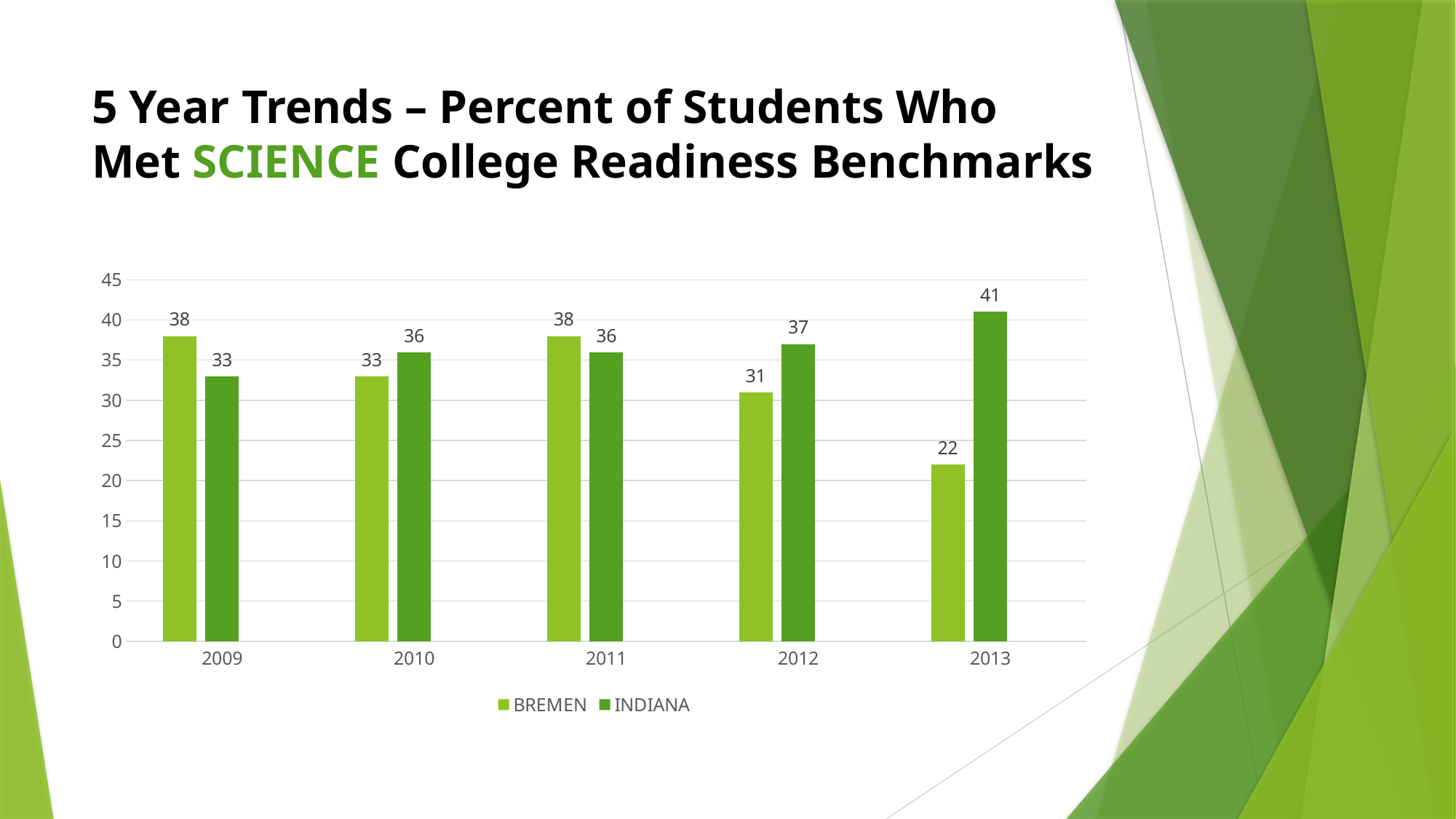
In which year is the INDIANA value highest? 2013 What is the difference between the INDIANA and BREMEN values in 2013? 19 What is the value for BREMEN in 2009? 38 What kind of chart is shown on the slide? bar chart Does the INDIANA series rise or fall from 2009 to 2013? rise Is the value for BREMEN in 2013 greater or less than 25? less How many years are shown on the x axis? 5 In which year is the BREMEN value lowest? 2013 Which is larger in 2011, BREMEN or INDIANA? BREMEN What is the value for BREMEN in 2012? 31 What is the value for INDIANA in 2013? 41 How many series does the legend list? 2